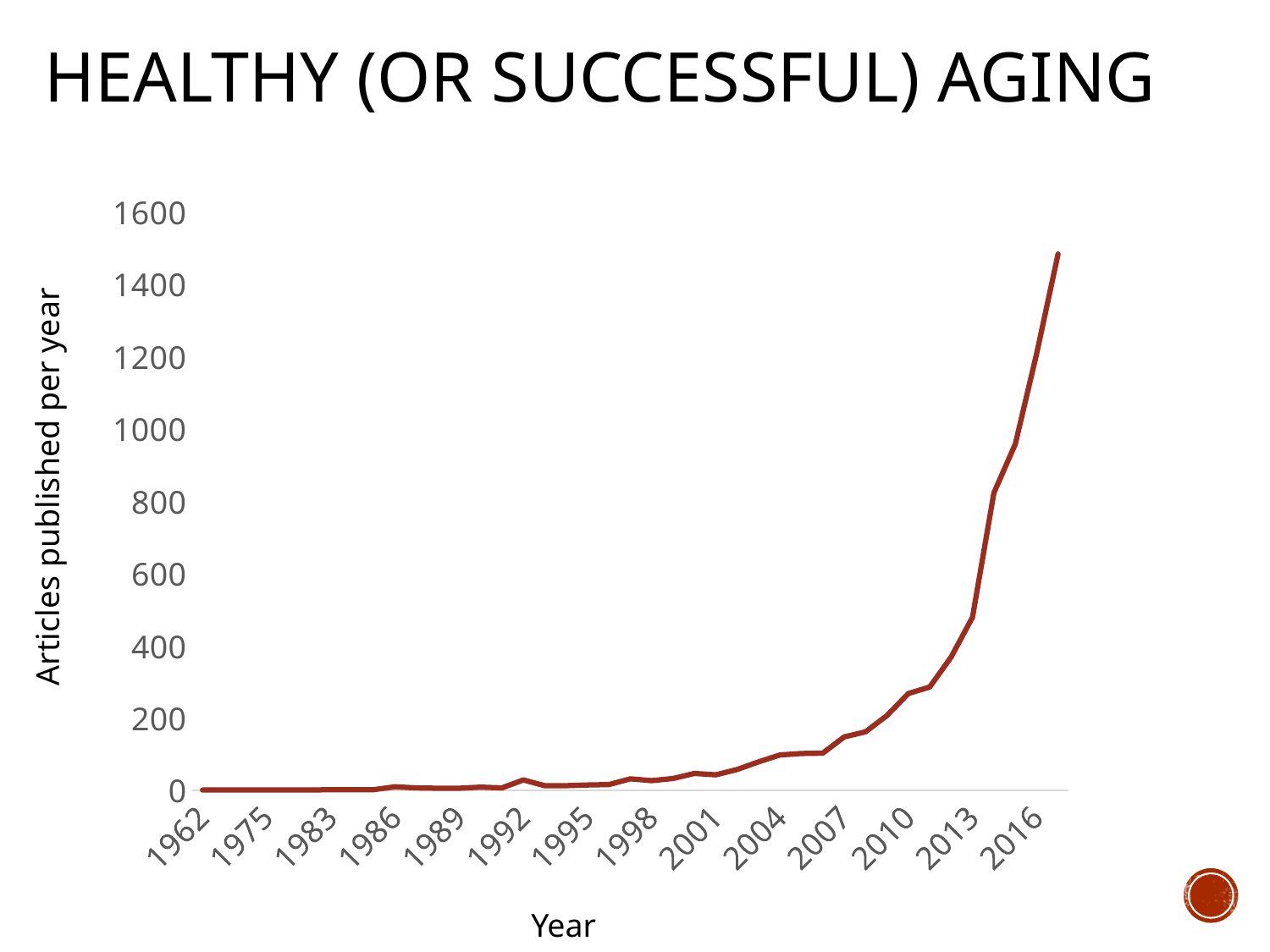
Is the value for 2016 greater or less than 600? greater Is the value for 1975 greater or less than 200? less Which is larger, the value for 2016 or the value for 2007? 2016 Is the value for 2013 greater or less than 800? less What kind of chart is shown on the slide? line chart What is the label of the vertical axis? Articles published per year What is the highest tick value shown on the vertical axis? 1600 How many year labels are shown on the x axis? 14 What is the title of the slide containing the chart? HEALTHY (OR SUCCESSFUL) AGING Do the values generally rise or fall as the years increase along the x axis? rise